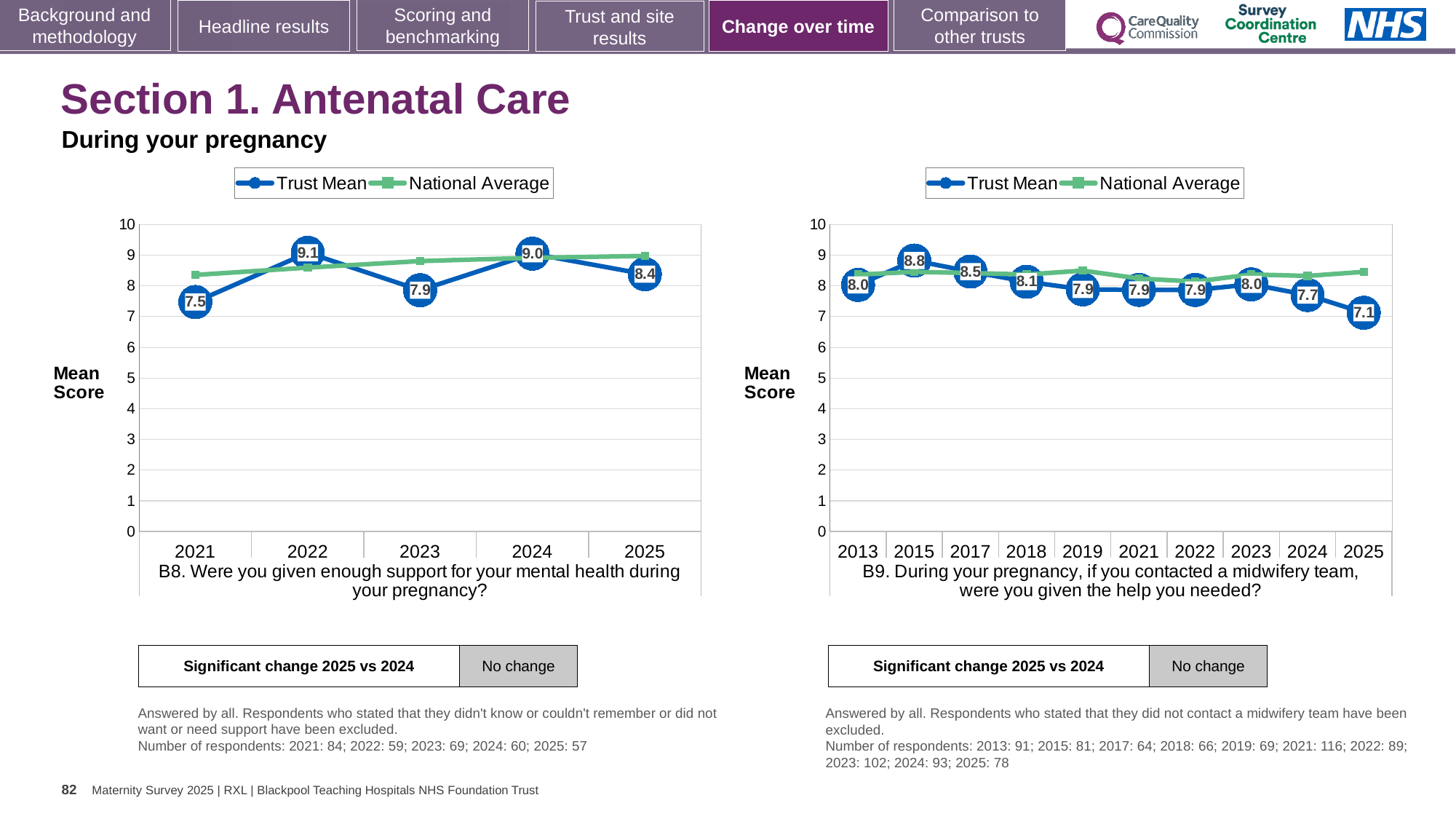
In the left chart (B8), how many series does the legend list? 2 In the right chart (B9), what is the Trust Mean for 2025? 7.1 What kind of chart is the right chart (B9)? Line chart In the right chart (B9), what is the difference between the Trust Mean in 2015 and in 2025? 1.7 In the right chart (B9), is the Trust Mean higher in 2017 or in 2024? 2017 In the left chart (B8), what is the Trust Mean for 2021? 7.5 In the right chart (B9), which year has the highest Trust Mean? 2015 In the right chart (B9), how many years are shown on the x axis? 10 In the left chart (B8), which year has the highest Trust Mean? 2022 In the left chart (B8), is the National Average for 2021 greater or less than 8? greater In the left chart (B8), what is the difference between the Trust Mean in 2022 and in 2023? 1.2 In the right chart (B9), which year has the lowest Trust Mean? 2025